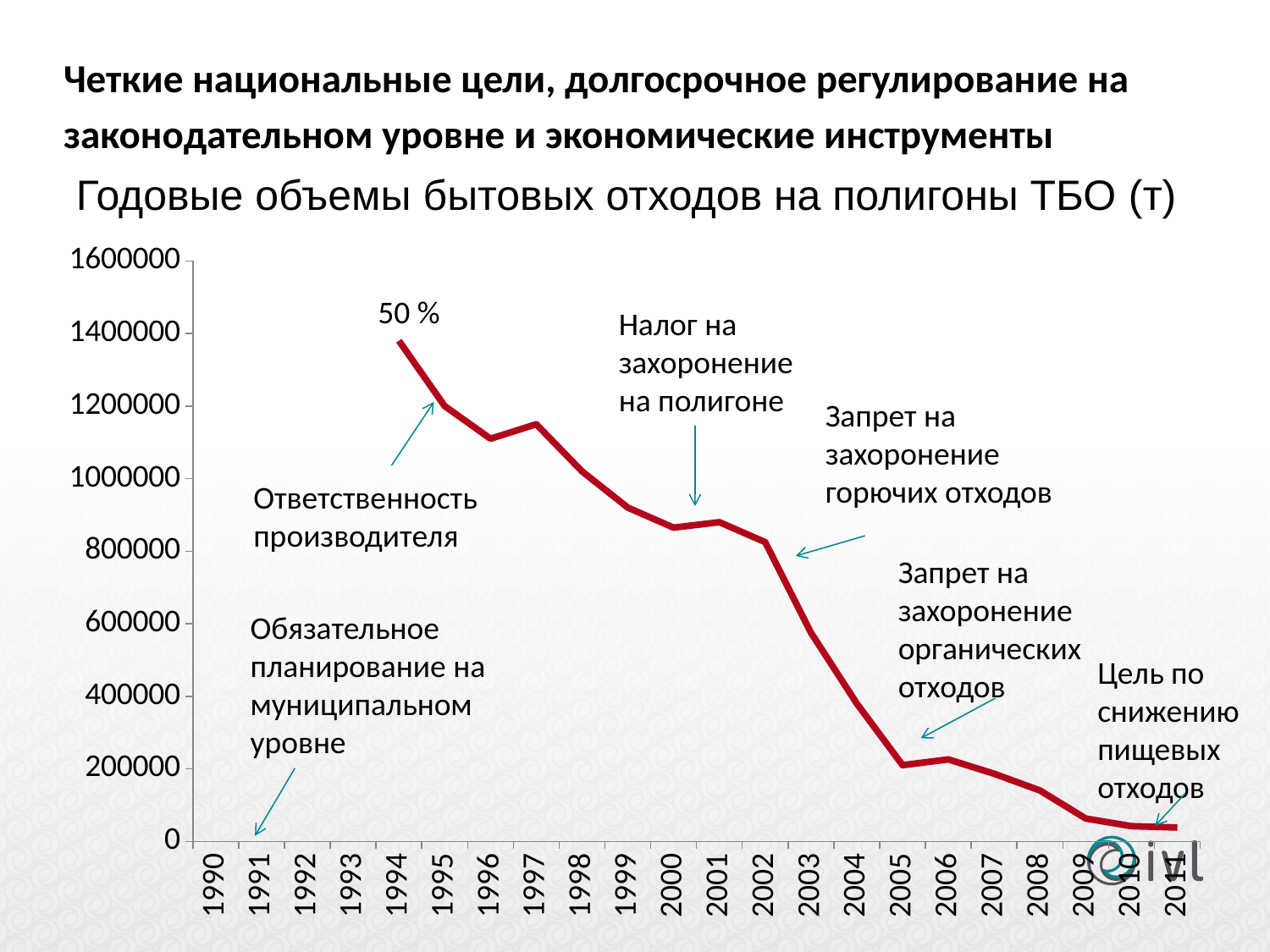
Is the value for 2003 greater or less than 800000? less Is the value for 2000 greater or less than 800000? greater Is the value for 1994 greater or less than 1200000? greater Which is larger, the value for 1995 or the value for 2005? 1995 Which year has the highest value on the chart? 1994 What is the title of the chart? Годовые объемы бытовых отходов на полигоны ТБО (т) Do the values generally rise or fall from 1994 to 2011? fall What kind of chart is shown on the slide? line chart What percentage label is printed near the 1994 data point? 50 % Which is larger, the value for 2003 or the value for 2004? 2003